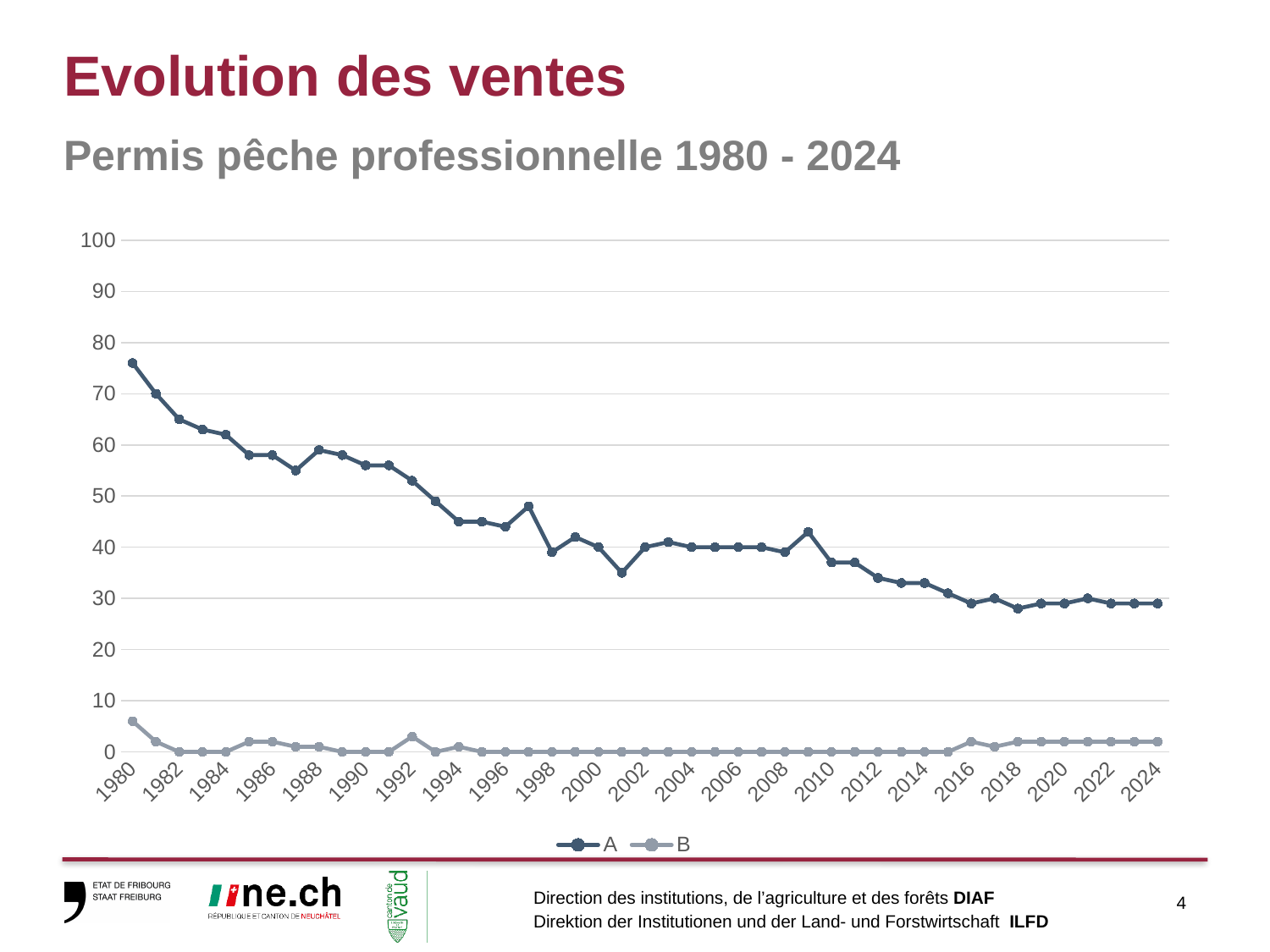
Does series A generally rise or fall from 1980 to 2024? fall In 1990, which series has the larger value, A or B? A Is the value of series A in 1980 greater or less than 70? greater What kind of chart is shown on the slide? line chart Is the value of series B in 2000 greater or less than 10? less Is the value of series A in 1990 greater or less than 50? greater How many series does the legend list? 2 In which year does series A reach its highest value? 1980 What is the subtitle of the chart on the slide? Permis pêche professionnelle 1980 - 2024 What are the names of the two series in the legend? A and B